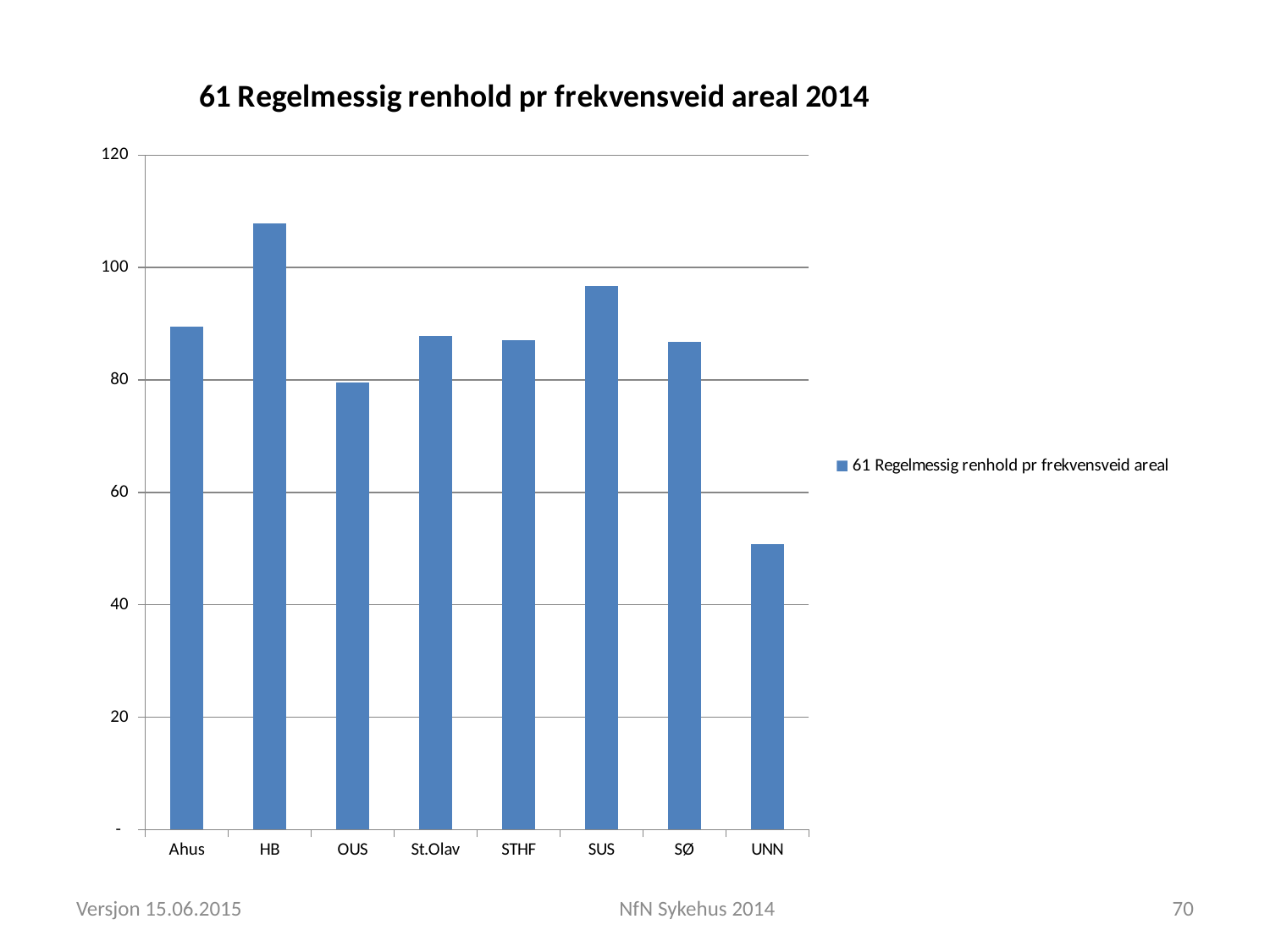
How many series does the legend list? 1 How many categories are shown on the x axis of the chart? 8 Is the value for SUS greater or less than 100? less Which category has the highest value? HB What kind of chart is shown on the slide? bar chart Which is larger, the value for UNN or the value for SUS? SUS What is the title of the chart? 61 Regelmessig renhold pr frekvensveid areal 2014 Is the value for UNN greater or less than 60? less Which category has the lowest value? UNN Is the value for HB greater or less than 100? greater Which is larger, the value for HB or the value for OUS? HB